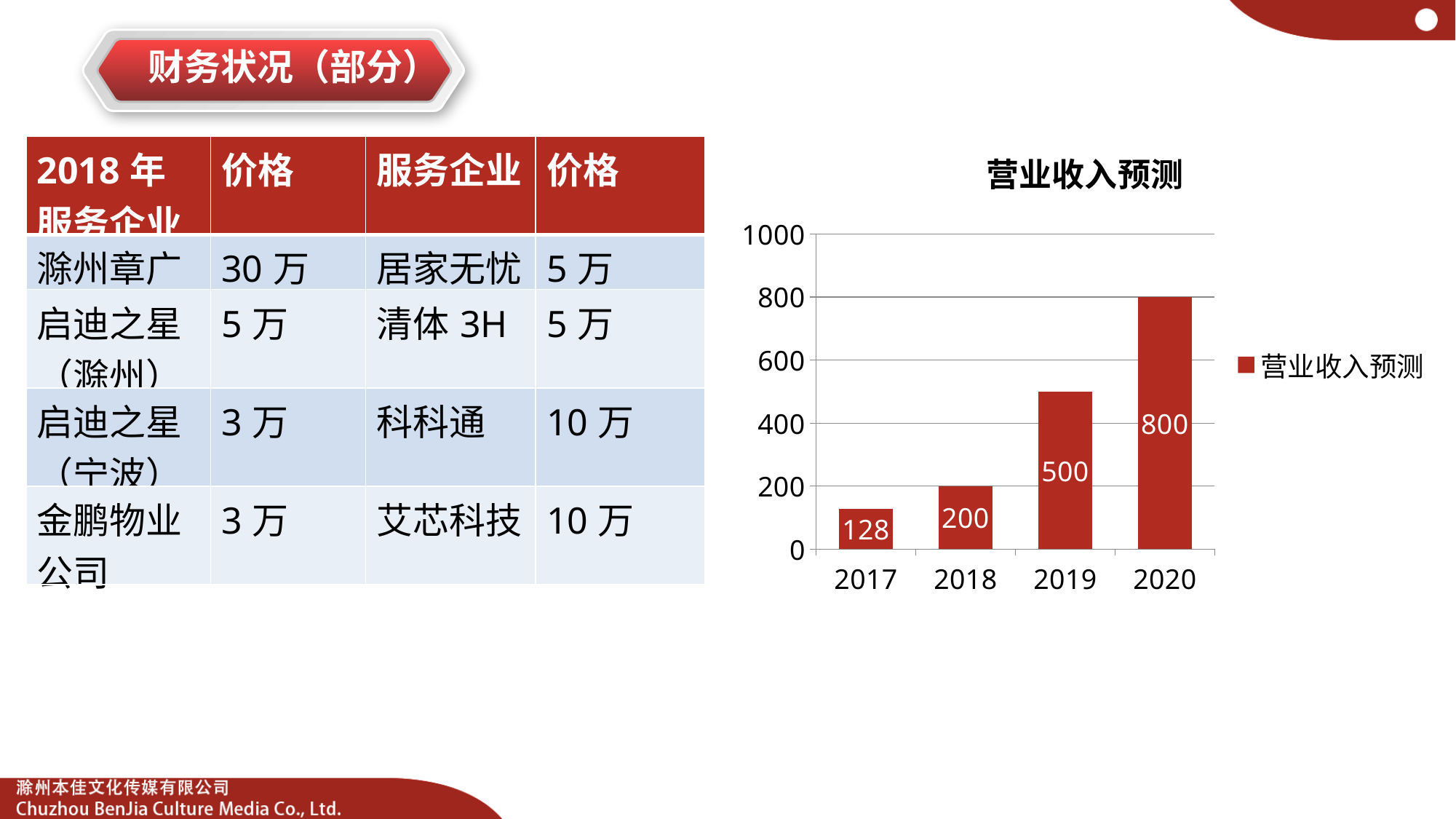
How many years are shown on the x axis of the 营业收入预测 chart? 4 Which year has the highest value in the 营业收入预测 chart? 2020 What is the value for 2019 in the 营业收入预测 chart? 500 What is the value for 2017 in the 营业收入预测 chart? 128 How many series does the legend of the 营业收入预测 chart list? 1 What is the value for 2020 in the 营业收入预测 chart? 800 What kind of chart is the 营业收入预测 chart? bar chart What is the difference between the values for 2020 and 2019 in the 营业收入预测 chart? 300 Which is larger in the 营业收入预测 chart, the value for 2018 or the value for 2019? 2019 Which year has the lowest value in the 营业收入预测 chart? 2017 What is the difference between the values for 2018 and 2017 in the 营业收入预测 chart? 72 Do the values in the 营业收入预测 chart rise or fall from 2017 to 2020? rise